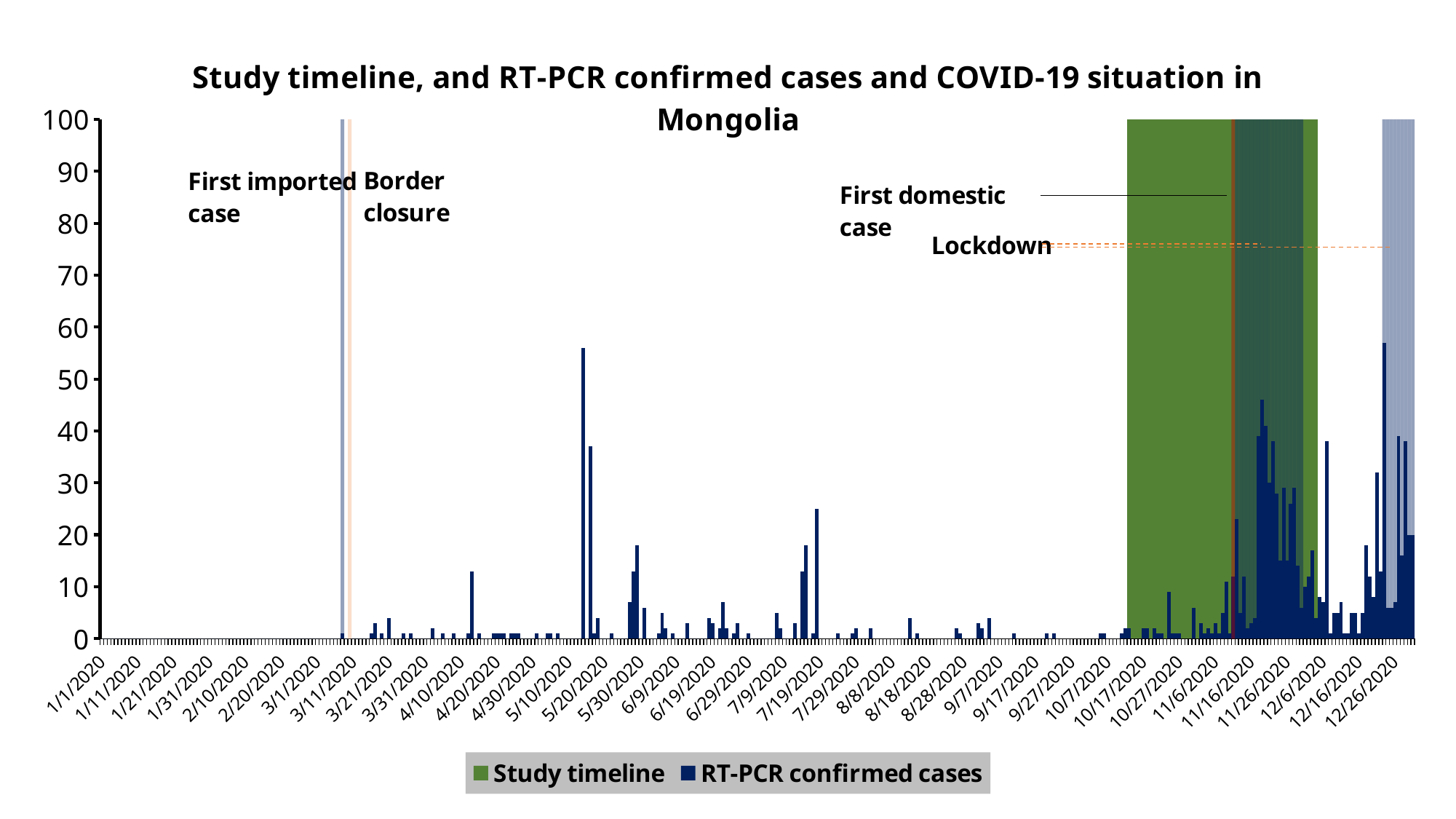
Which is larger: the tallest bar of confirmed cases around 7/19/2020 or the tallest bar around 5/30/2020? 7/19/2020 Which is larger: the tallest bar of confirmed cases around 5/20/2020 or the tallest bar around 7/19/2020? 5/20/2020 What does the green shaded region on the chart represent? Study timeline Is the tallest bar of RT-PCR confirmed cases around 7/19/2020 greater or less than 20? greater How many series does the legend list? 2 Is the tallest bar of RT-PCR confirmed cases around 5/20/2020 greater or less than 50? greater What kind of chart is used to show the RT-PCR confirmed cases? Bar chart Is the tallest bar of RT-PCR confirmed cases around 5/30/2020 greater or less than 20? less What are the two entries in the chart legend? Study timeline and RT-PCR confirmed cases